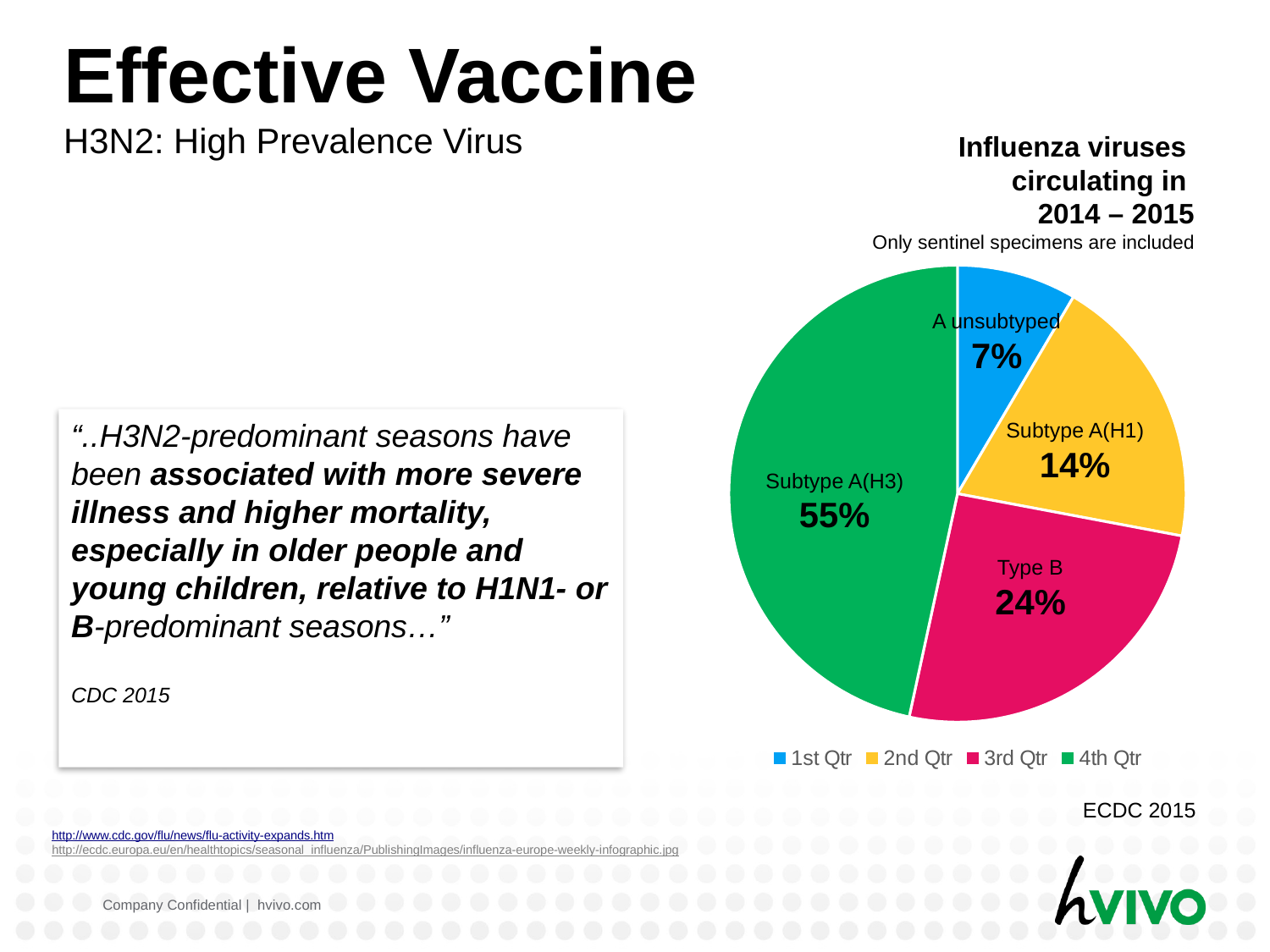
What percentage is shown for Type B? 24% What kind of chart is shown on the slide? Pie chart What is the difference in percentage points between Subtype A(H3) and Type B? 31 Which slice of the pie is the largest? Subtype A(H3) What percentage is shown for A unsubtyped? 7% Which slice of the pie is the smallest? A unsubtyped Which is larger, the share for Type B or the share for Subtype A(H1)? Type B What share of the pie does Subtype A(H3) account for? 55% What percentage is shown for Subtype A(H1)? 14% How many entries does the legend list? 4 How many slices does the pie chart have? 4 What is the title of the pie chart? Influenza viruses circulating in 2014 – 2015